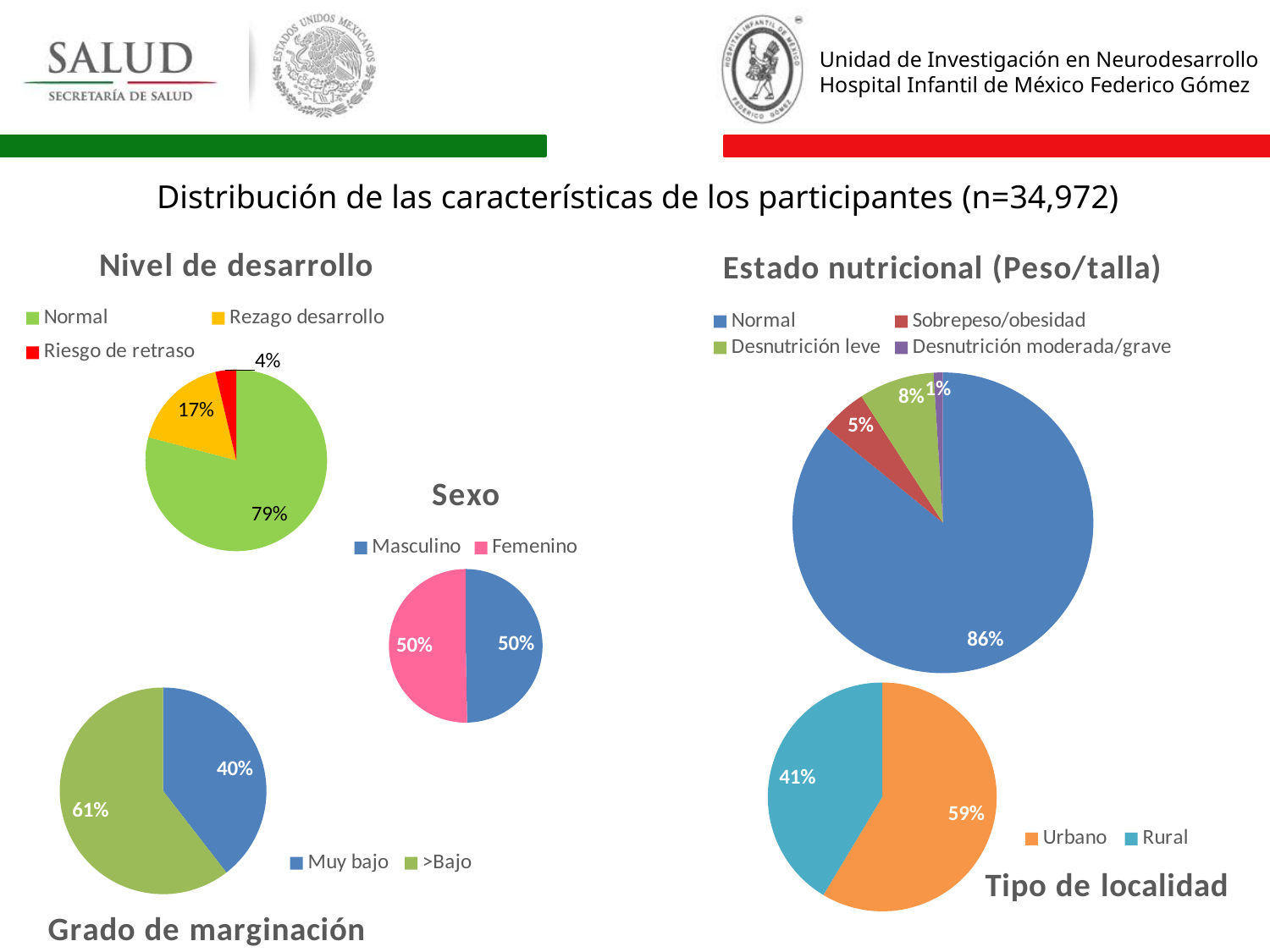
What type of chart is used for 'Tipo de localidad'? Pie chart In the 'Estado nutricional (Peso/talla)' chart, what is the difference between the Normal and Sobrepeso/obesidad percentages? 81% In the 'Tipo de localidad' chart, which is larger, Urbano or Rural? Urbano In the 'Tipo de localidad' chart, what is the difference between the Urbano and Rural percentages? 18% In the 'Nivel de desarrollo' chart, what share of participants is labelled Normal? 79% How many categories does the legend of the 'Estado nutricional (Peso/talla)' chart list? 4 In the 'Estado nutricional (Peso/talla)' chart, which category has the largest slice? Normal In the 'Nivel de desarrollo' chart, what percentage is shown for Rezago desarrollo? 17% In the 'Nivel de desarrollo' chart, which category has the smallest slice? Riesgo de retraso In the 'Estado nutricional (Peso/talla)' chart, what percentage is shown for Desnutrición leve? 8% In the 'Grado de marginación' chart, what percentage is shown for Muy bajo? 40% In the 'Sexo' chart, what percentage is shown for Femenino? 50%